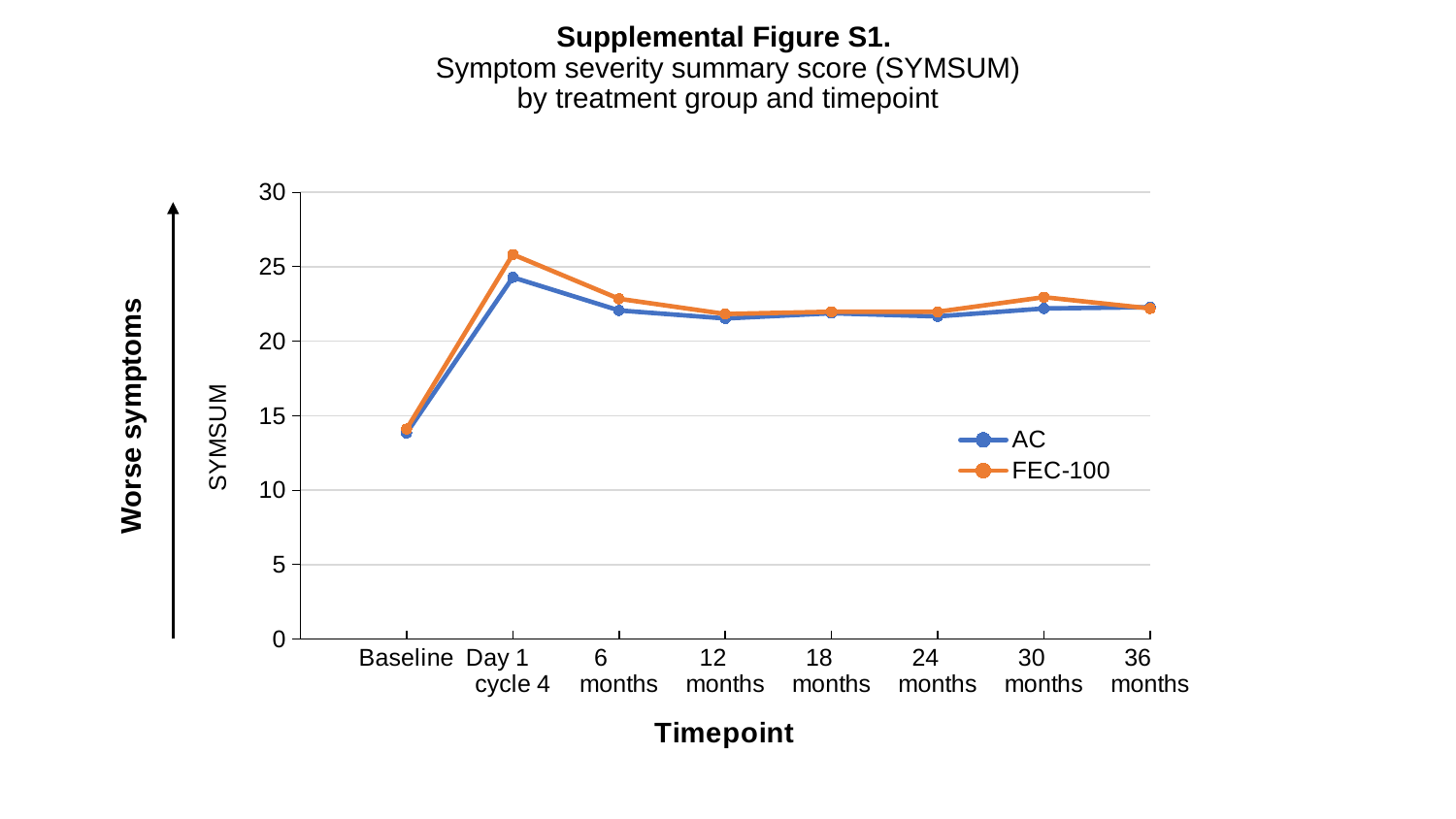
What is the label of the x axis? Timepoint At Day 1 cycle 4, which treatment group has the higher SYMSUM value, AC or FEC-100? FEC-100 How many series does the legend list? 2 What kind of chart is shown on the slide? Line chart Do the SYMSUM values rise or fall from Baseline to Day 1 cycle 4? Rise At which timepoint does the FEC-100 series reach its highest SYMSUM value? Day 1 cycle 4 At which timepoint does the AC series have its lowest SYMSUM value? Baseline Which colour represents the FEC-100 series? Orange Is the SYMSUM value for AC at Baseline greater or less than 15? less Is the SYMSUM value for AC at Day 1 cycle 4 greater or less than 25? less How many timepoints are plotted along the x axis? 8 Is the SYMSUM value for FEC-100 at Day 1 cycle 4 greater or less than 25? greater